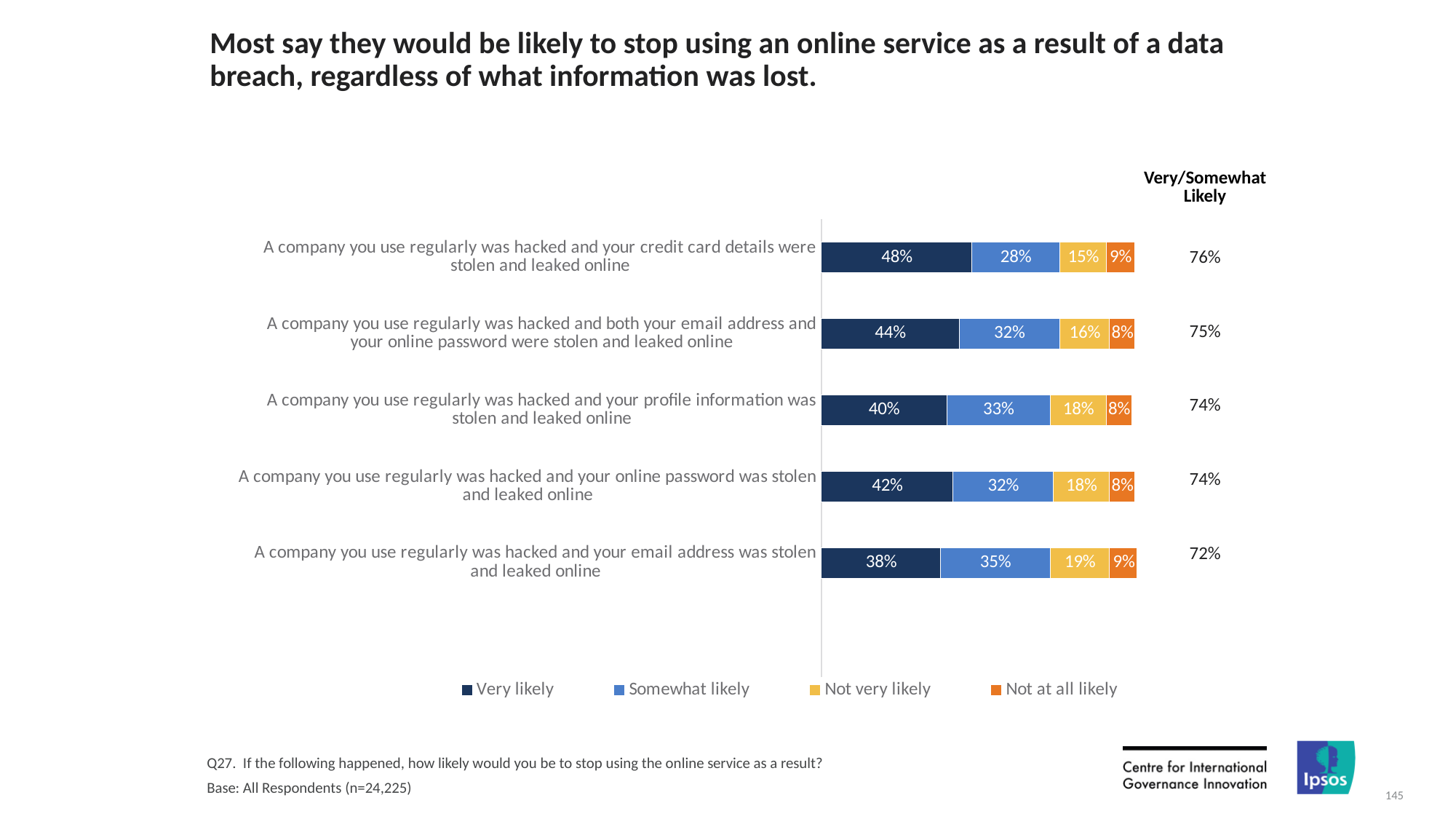
Which is larger: the 'Somewhat likely' value for the online password scenario or for the credit card details scenario? Online password scenario (32%) What is the 'Not at all likely' value for the scenario where both email address and online password were stolen and leaked online? 8% What is the combined 'Very/Somewhat Likely' value for the scenario where the online password was stolen and leaked online? 74% How many series does the legend list? 4 Which scenario has the highest 'Very likely' value? A company you use regularly was hacked and your credit card details were stolen and leaked online How many scenarios (categories) are shown in the chart? 5 What kind of chart is shown on the slide? Stacked bar chart What is the difference between the 'Very likely' values for the credit card details scenario and the email address scenario? 10% What percentage of respondents are 'Very likely' to stop using the service if their credit card details were stolen and leaked online? 48% Which scenario has the lowest 'Very likely' value? A company you use regularly was hacked and your email address was stolen and leaked online What is the 'Not very likely' value for the scenario where profile information was stolen and leaked online? 18% What is the 'Somewhat likely' value for the scenario where the email address was stolen and leaked online? 35%